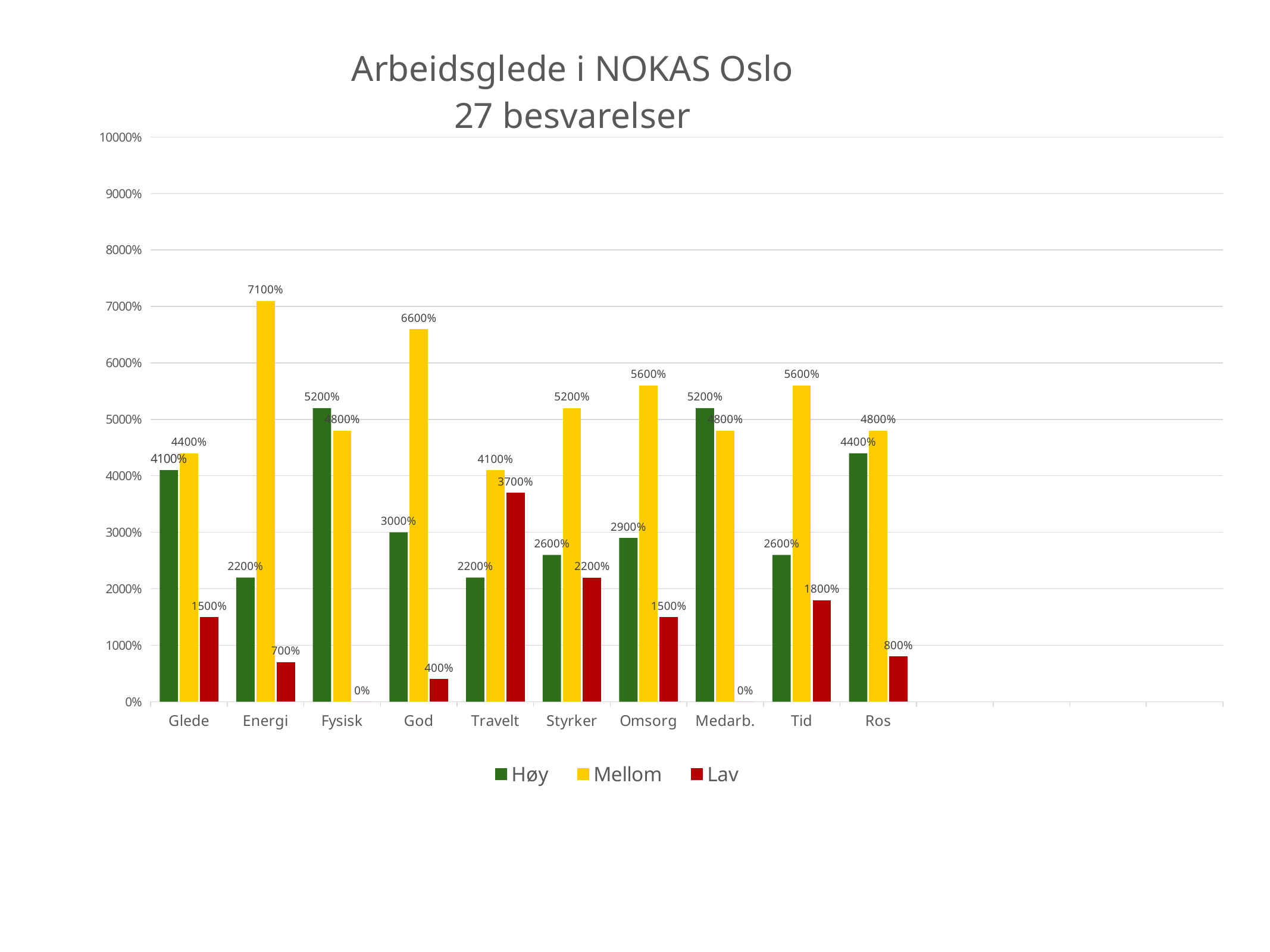
How many series does the legend list? 3 Which is larger for Fysisk, the Høy value or the Mellom value? Høy What is the Høy value for Omsorg? 2900% How many categories are shown on the x axis? 10 What is the difference between the Mellom and Høy values for God? 3600% What kind of chart is shown on the slide? Bar chart Which category has the highest Mellom value? Energi Which category has the highest Lav value? Travelt What is the title of the chart? Arbeidsglede i NOKAS Oslo 27 besvarelser What is the Lav value for Travelt? 3700% Which category has the lowest Høy value? Energi and Travelt (both 2200%) What is the Mellom value for Energi? 7100%